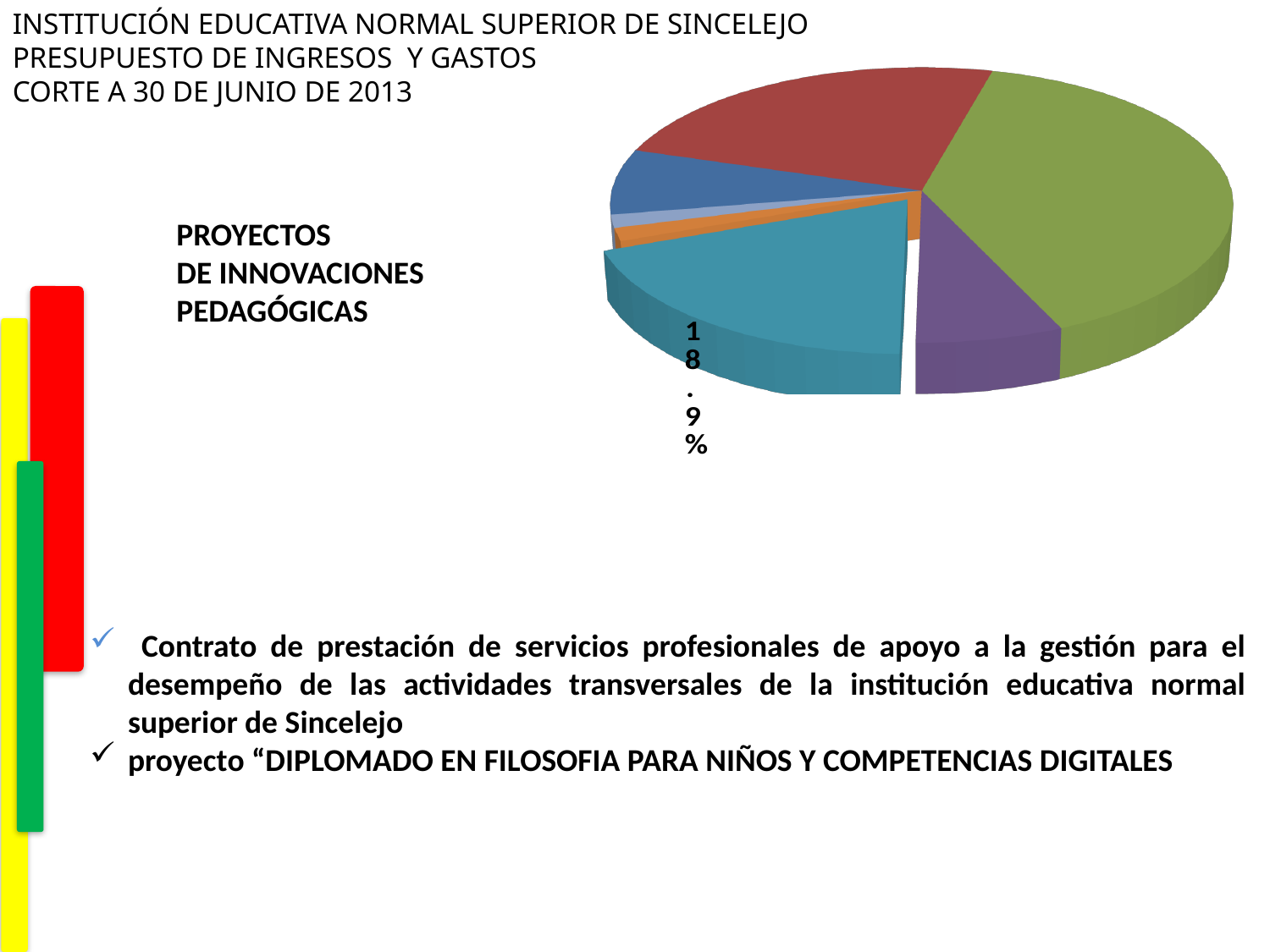
Which is larger in the pie chart, the green slice or the teal slice? the green slice What kind of chart is shown on the slide? pie chart Which slice of the pie chart is pulled out (exploded) from the rest? the teal slice labelled 18.9% What percentage value is printed as a data label on the pie chart? 18.9% Which colour slice is the largest in the pie chart? green What heading appears to the left of the pie chart describing the highlighted budget item? PROYECTOS DE INNOVACIONES PEDAGÓGICAS Which is larger in the pie chart, the red slice or the purple slice? the red slice How many slices does the pie chart have? 7 What share of the pie does the exploded teal slice represent? 18.9% Which is larger in the pie chart, the green slice or the red slice? the green slice